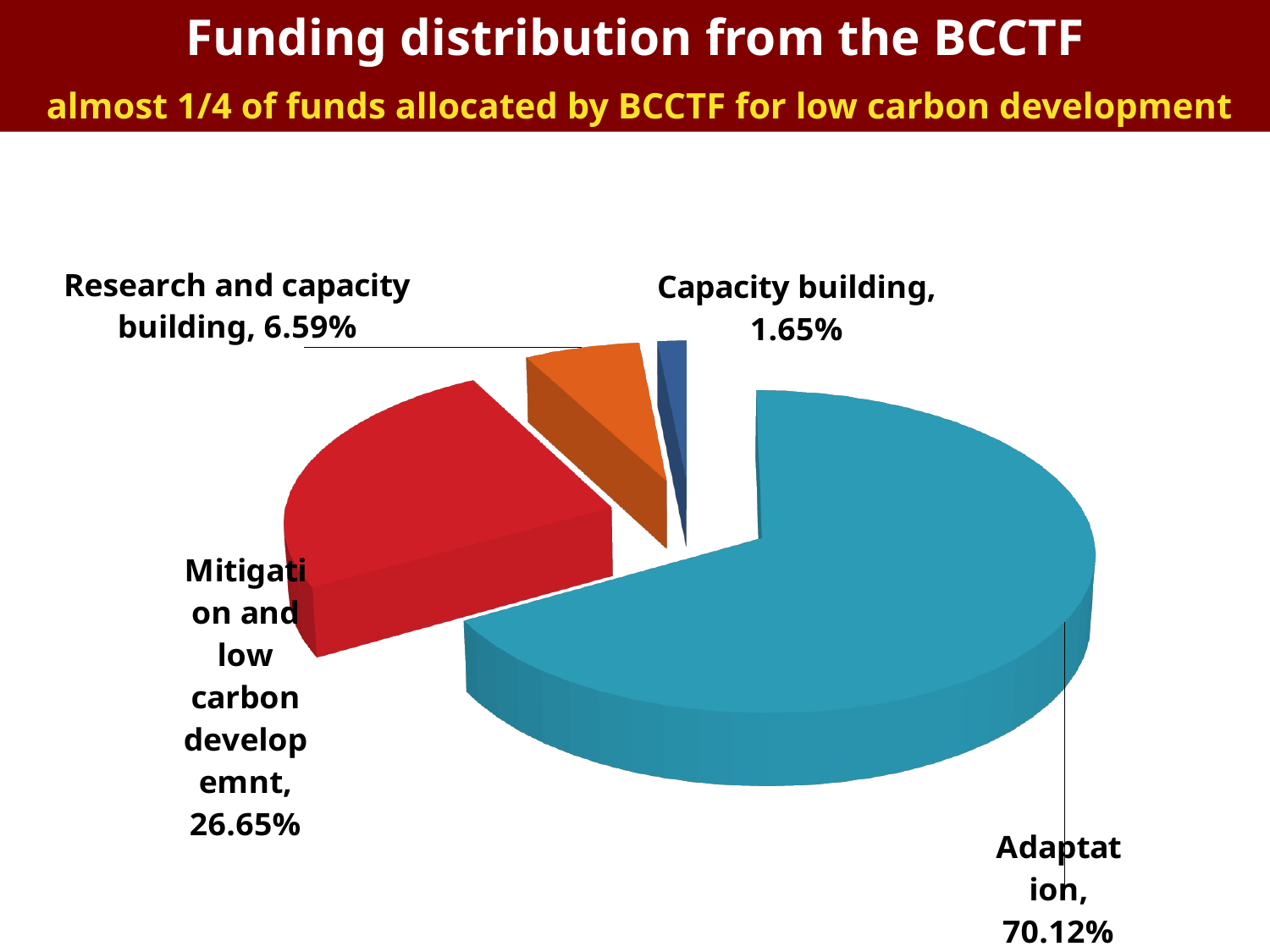
What share of funding goes to Adaptation? 70.12% What share of funding goes to Mitigation and low carbon development? 26.65% What is the difference in percentage points between Adaptation and Mitigation and low carbon development? 43.47 Which is larger, the share for Research and capacity building or the share for Capacity building? Research and capacity building What share of funding goes to Research and capacity building? 6.59% How many slices does the pie chart have? 4 What is the title of the chart on the slide? Funding distribution from the BCCTF What kind of chart is shown on the slide? Pie chart What share of funding goes to Capacity building? 1.65% Which category receives the largest share of funding? Adaptation What is the difference in percentage points between Research and capacity building and Capacity building? 4.94 Which category receives the smallest share of funding? Capacity building